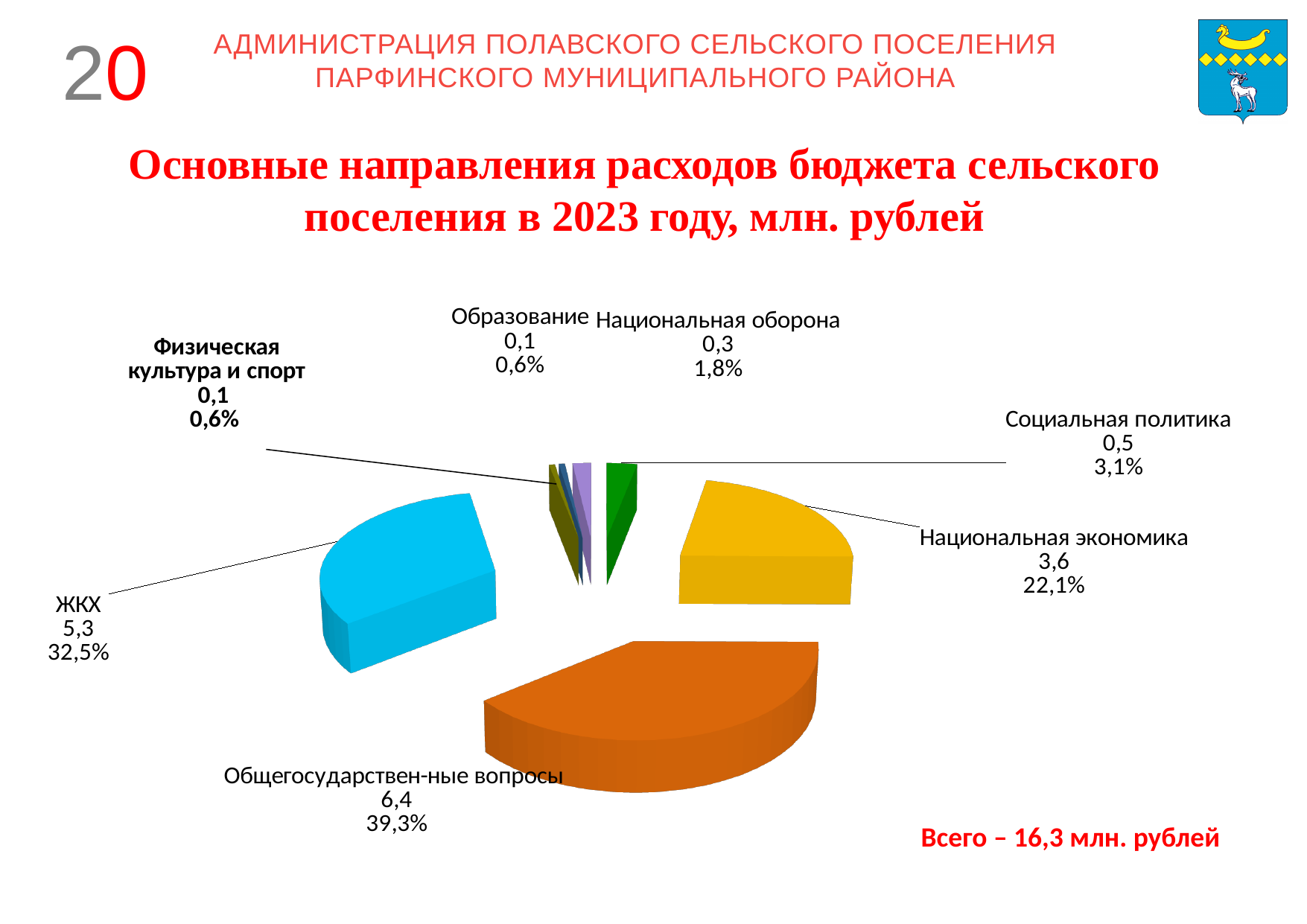
How many categories does the pie chart show? 7 What share of the pie does Национальная оборона have? 1,8% What is the difference between the values for Общегосударственные вопросы and ЖКХ? 1,1 What share of the pie does Национальная экономика have? 22,1% What is the value for ЖКХ in the pie chart? 5,3 Which is larger, the value for Национальная оборона or the value for Социальная политика? Социальная политика What type of chart is shown on the slide? pie chart What is the value for Социальная политика? 0,5 What total is stated on the slide for the budget expenditures? 16,3 млн. рублей What share of the pie does Общегосударственные вопросы have? 39,3% What is the value for Образование? 0,1 Which category has the largest slice of the pie? Общегосударственные вопросы